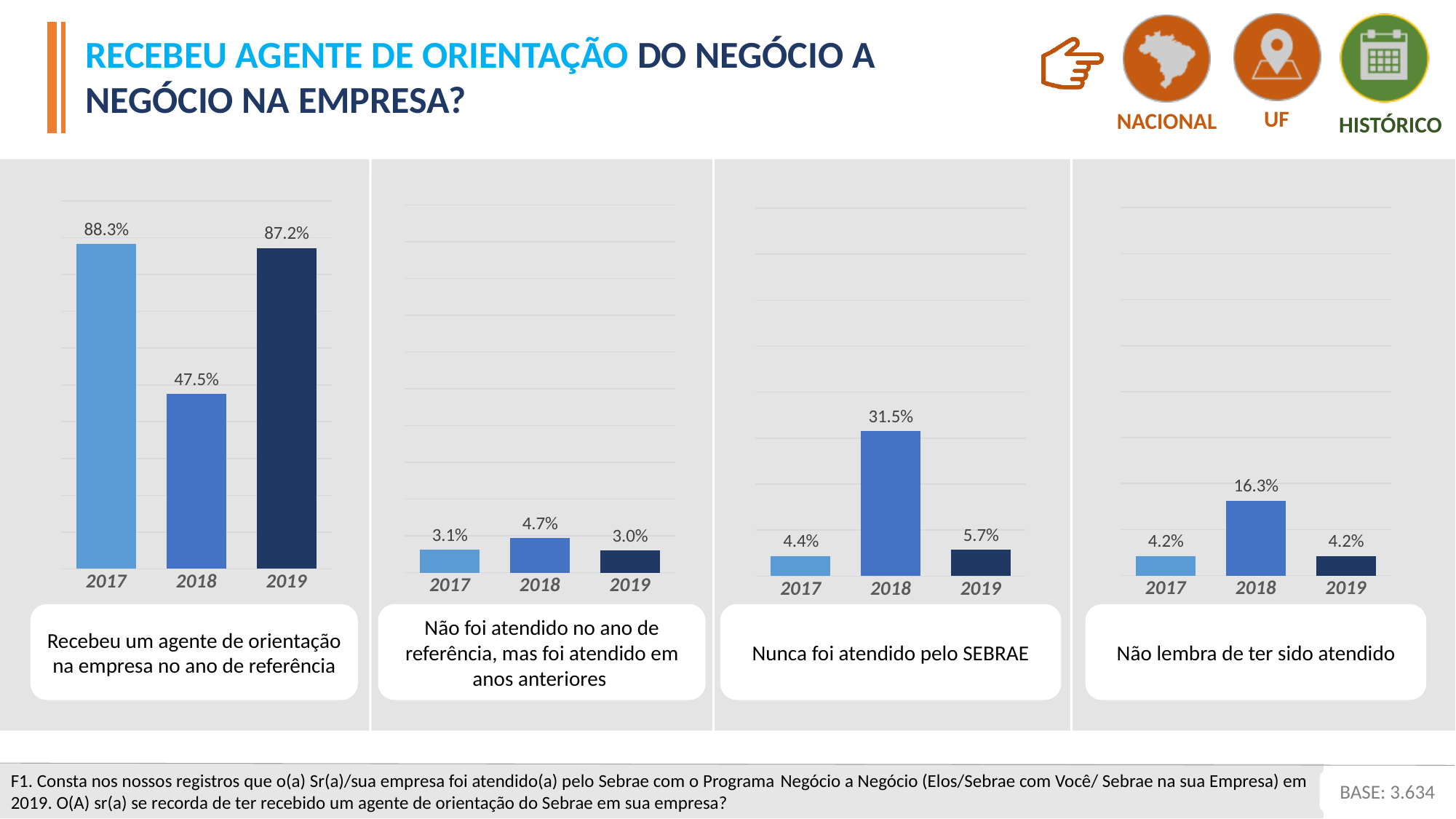
In the chart 'Nunca foi atendido pelo SEBRAE', what is the difference between the 2018 and 2019 values? 25.8% In the chart 'Nunca foi atendido pelo SEBRAE', which is larger, the value for 2017 or the value for 2019? 2019 In the chart 'Recebeu um agente de orientação na empresa no ano de referência', what is the difference between the 2017 and 2019 values? 1.1% In the chart 'Recebeu um agente de orientação na empresa no ano de referência', what is the value for 2018? 47.5% What kind of chart is used in the 'Nunca foi atendido pelo SEBRAE' panel? Bar chart In the chart 'Nunca foi atendido pelo SEBRAE', what is the value for 2018? 31.5% In the chart 'Recebeu um agente de orientação na empresa no ano de referência', which year has the highest value? 2017 How many years are shown in the chart 'Não lembra de ter sido atendido'? 3 In the chart 'Não foi atendido no ano de referência, mas foi atendido em anos anteriores', which year has the lowest value? 2019 In the chart 'Não lembra de ter sido atendido', what is the value for 2018? 16.3% In the chart 'Não lembra de ter sido atendido', what is the value for 2019? 4.2% In the chart 'Não foi atendido no ano de referência, mas foi atendido em anos anteriores', what is the value for 2018? 4.7%